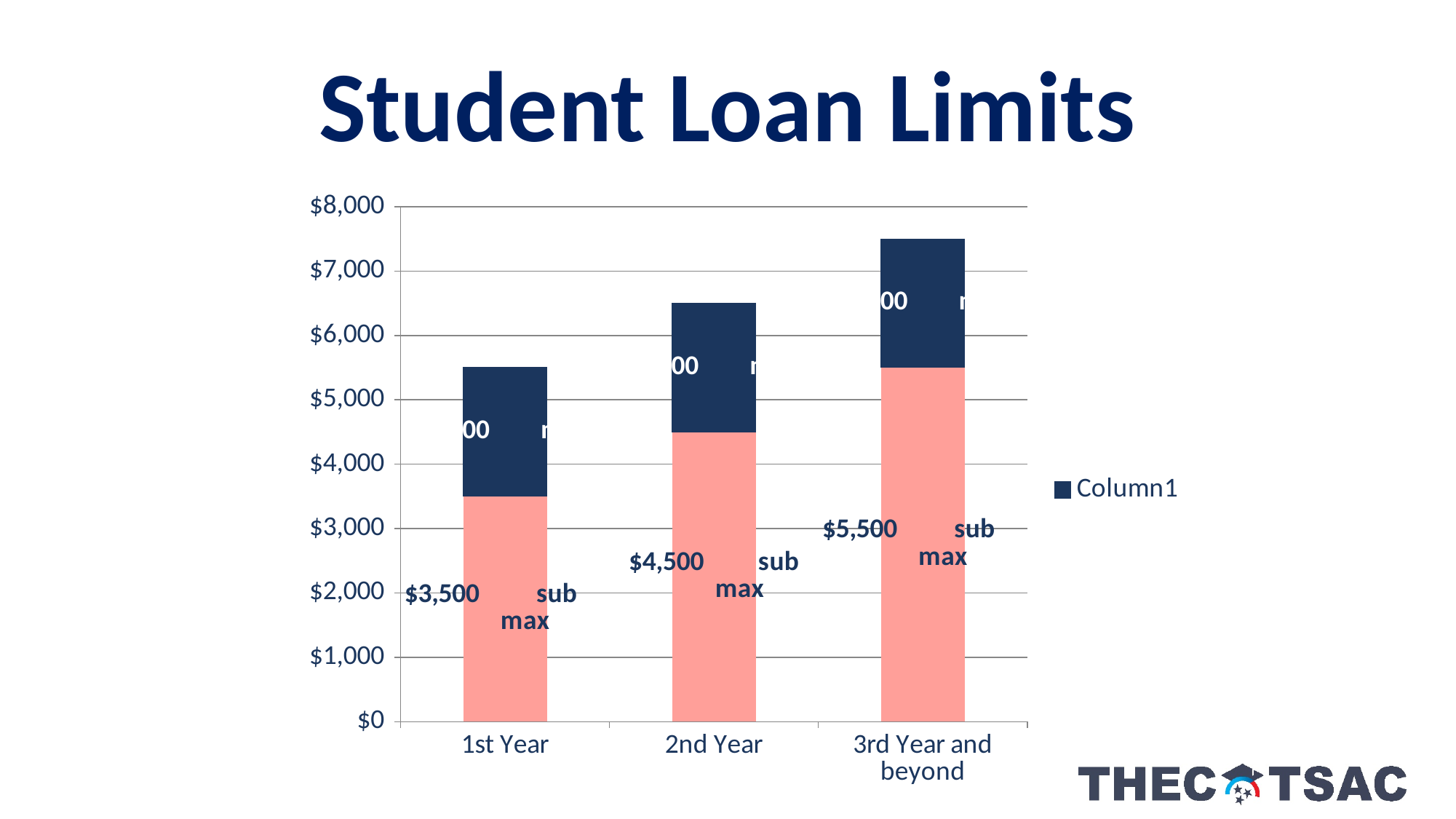
Do the sub max values rise or fall from 1st Year to 3rd Year and beyond? rise What is the difference between the sub max values for 3rd Year and beyond and 1st Year? $2,000 What kind of chart is shown on the slide? bar chart What is the sub max value for 1st Year? $3,500 Which category has the lowest sub max value? 1st Year Is the total height of the 1st Year bar greater or less than $5,000? greater Is the total height of the 3rd Year and beyond bar greater or less than $7,000? greater Which has a larger sub max value, 2nd Year or 3rd Year and beyond? 3rd Year and beyond What is the sub max value for 2nd Year? $4,500 What is the sub max value for 3rd Year and beyond? $5,500 Which category has the highest sub max value? 3rd Year and beyond How many categories are shown on the x axis? 3